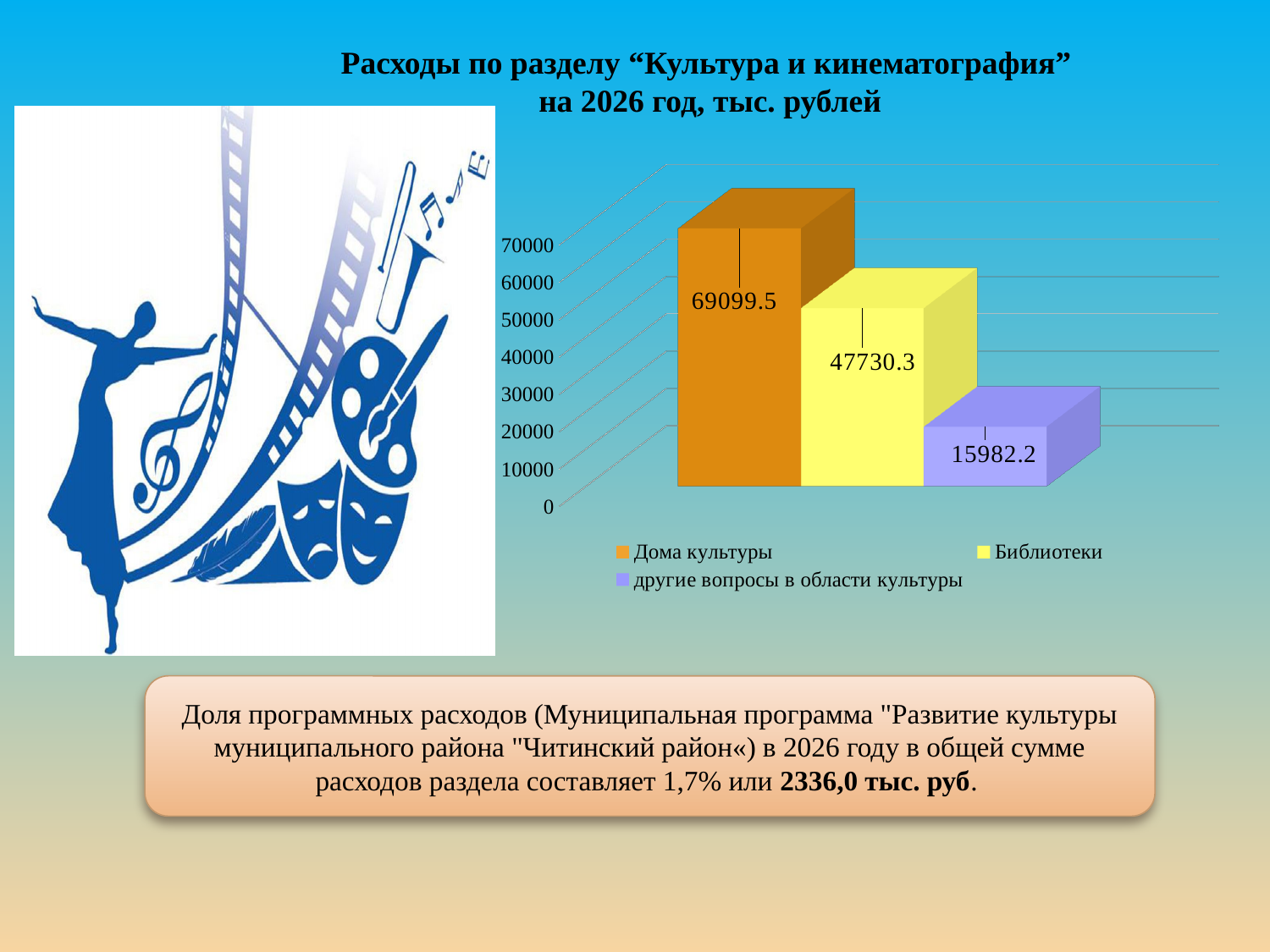
What kind of chart is shown on the slide? bar chart What is the difference between the values for Библиотеки and другие вопросы в области культуры? 31748.1 What is the value for Дома культуры? 69099.5 Which is larger, the value for Библиотеки or the value for другие вопросы в области культуры? Библиотеки Which category has the highest value? Дома культуры What is the value for другие вопросы в области культуры? 15982.2 How many series does the legend list? 3 What is the value for Библиотеки? 47730.3 Is the value for Дома культуры greater or less than 60000? greater What colour is the bar for Библиотеки? yellow What is the difference between the values for Дома культуры and Библиотеки? 21369.2 Which category has the lowest value? другие вопросы в области культуры